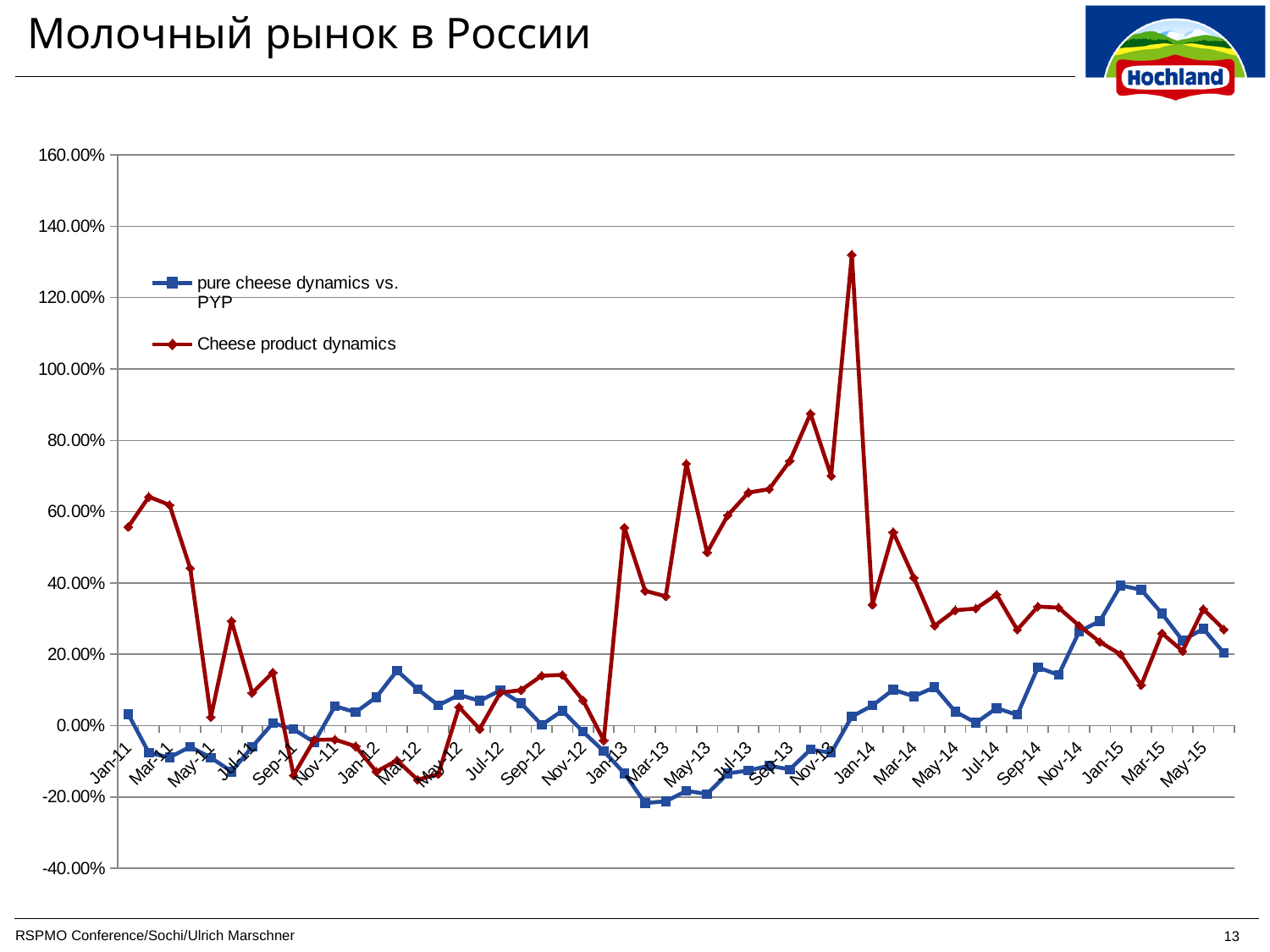
Is the peak value of the Cheese product dynamics series greater or less than 120.00%? greater Which series is drawn in red with diamond markers? Cheese product dynamics Does the pure cheese dynamics vs. PYP series rise or fall between Sep-14 and Jan-15? rise Is the value of Cheese product dynamics at Jan-11 greater or less than 40.00%? greater At Jan-11, which series has the larger value: pure cheese dynamics vs. PYP or Cheese product dynamics? Cheese product dynamics How many series does the legend list? 2 What is the title of the slide containing the chart? Молочный рынок в России Does the Cheese product dynamics series rise or fall between Jan-11 and May-11? fall What kind of chart is shown on the slide? line chart At Jan-15, which series has the larger value: pure cheese dynamics vs. PYP or Cheese product dynamics? pure cheese dynamics vs. PYP Is the value of pure cheese dynamics vs. PYP at Jan-15 greater or less than 20.00%? greater Which series reaches the highest value anywhere on the chart? Cheese product dynamics